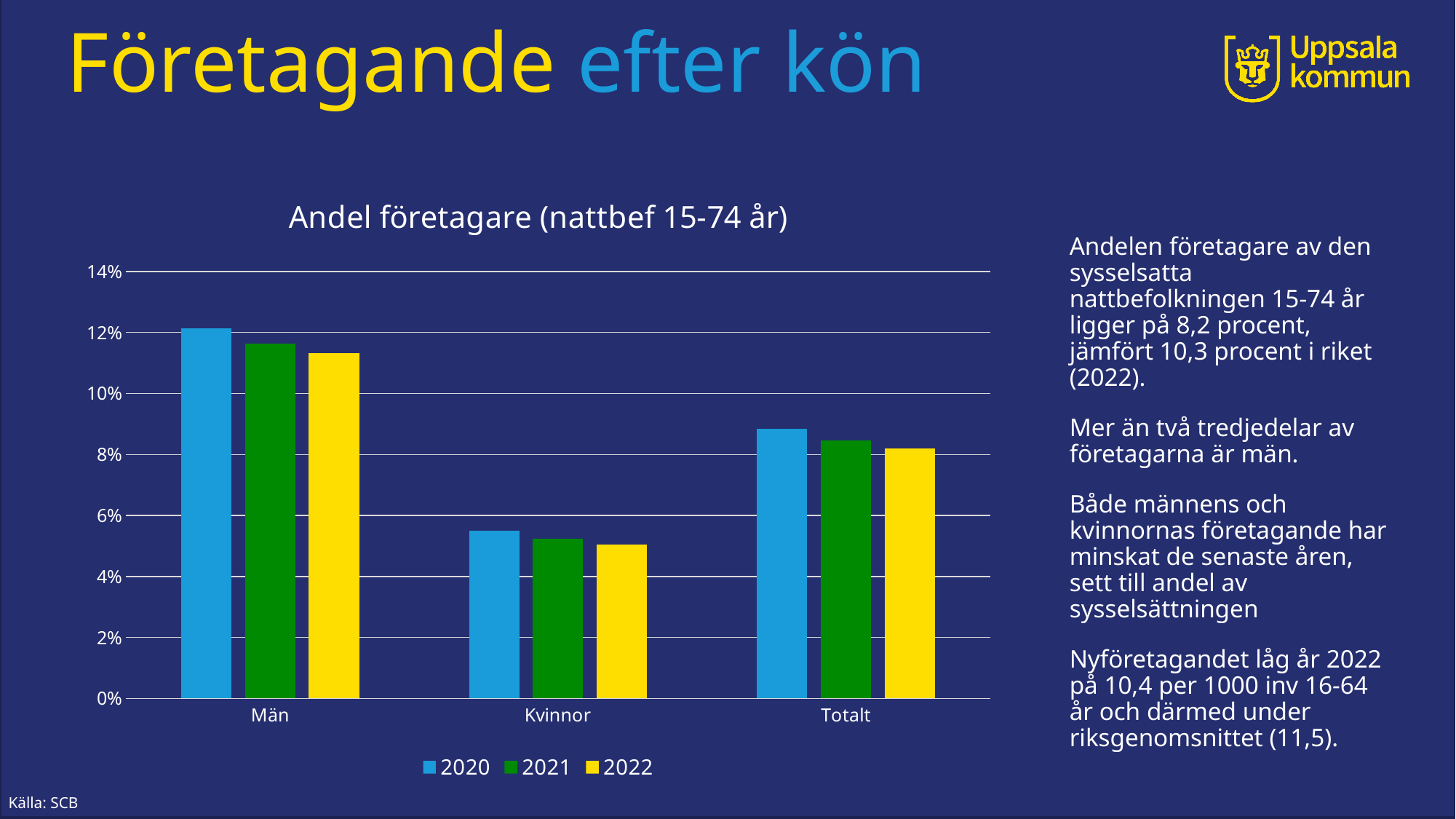
Which category has the highest value for 2020? Män Which is larger, the 2021 value for Män or the 2021 value for Totalt? Män What is the title of the chart? Andel företagare (nattbef 15-74 år) Is the value for Kvinnor in 2022 greater or less than 6%? less Is the value for Män in 2020 greater or less than 10%? greater Is the value for Totalt in 2020 greater or less than 8%? greater Do the values for Män rise or fall from 2020 to 2022? fall Which category has the lowest value for 2022? Kvinnor Which colour represents the 2022 series in the chart? yellow What kind of chart is shown on the slide? bar chart How many series does the chart legend list? 3 How many categories are shown on the x axis of the chart? 3